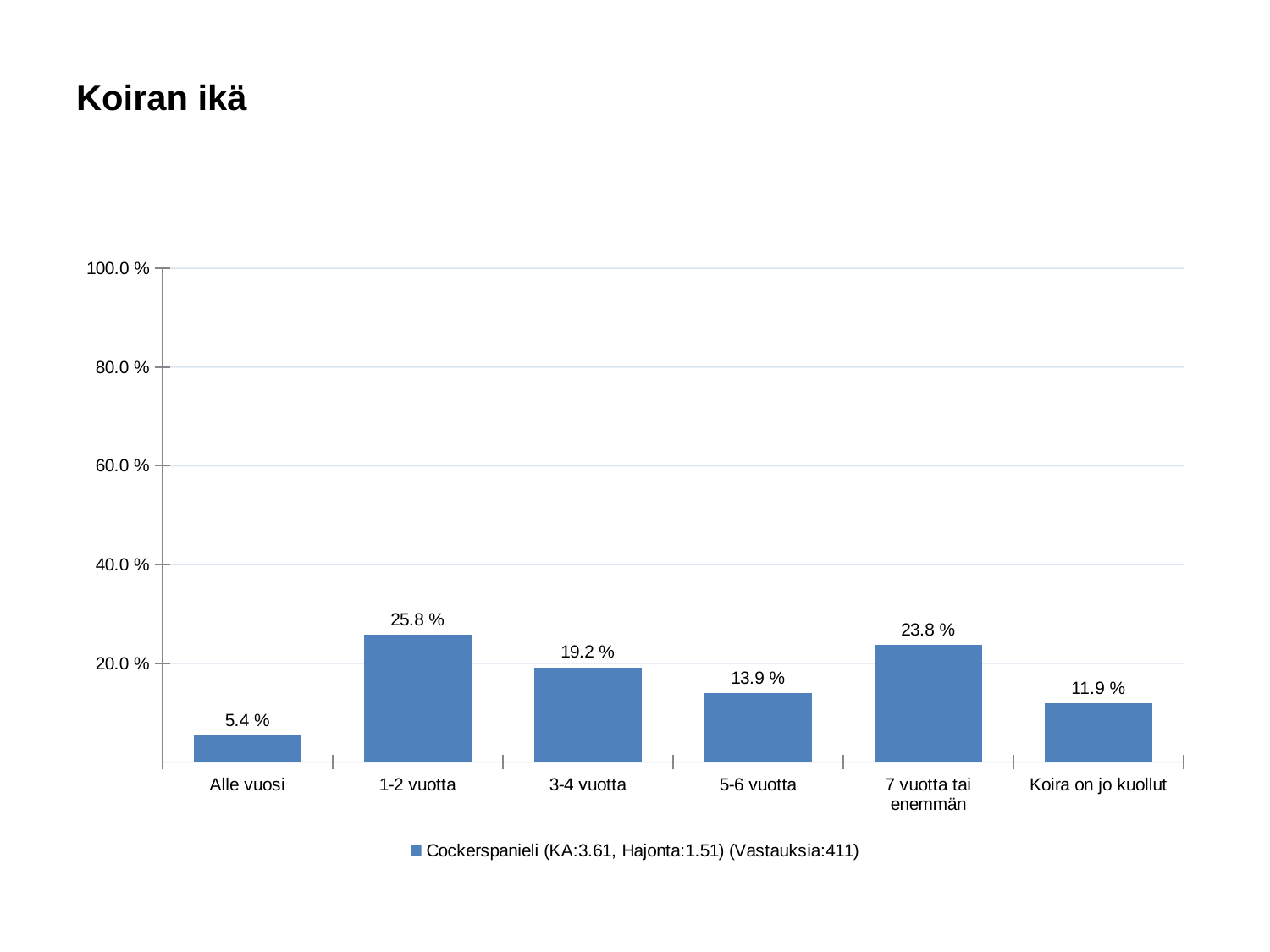
What is the value for the 'Koira on jo kuollut' category? 11.9 % What is the title of the slide? Koiran ikä Is the value for '7 vuotta tai enemmän' greater or less than 20.0 %? greater How many series does the legend list? 1 How many categories are shown on the x axis? 6 What is the difference between the values for '1-2 vuotta' and '7 vuotta tai enemmän'? 2.0 % Which category has the highest value? 1-2 vuotta Which category has the lowest value? Alle vuosi What is the value for the '5-6 vuotta' category? 13.9 % What is the value for the '1-2 vuotta' category? 25.8 % What kind of chart is shown on the slide? bar chart Which is larger, the value for '3-4 vuotta' or the value for '5-6 vuotta'? 3-4 vuotta